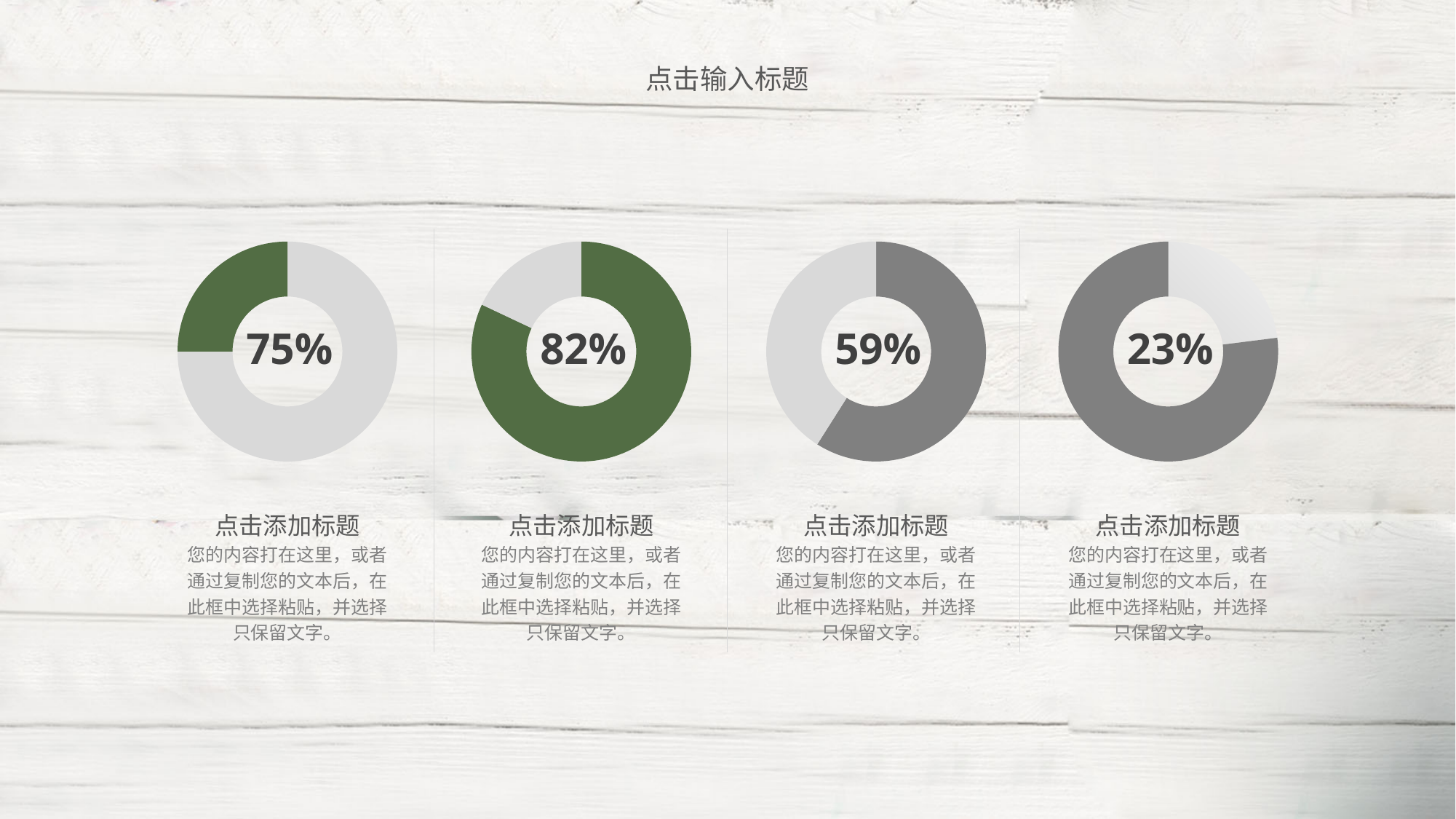
What is the difference between the percentage in the leftmost donut chart and the percentage in the third donut chart? 16% Which of the four donut charts shows the highest percentage? The second from the left (82%) Which shows a larger percentage, the leftmost donut chart or the third donut chart from the left? The leftmost (75%) What percentage is shown in the center of the third donut chart from the left? 59% What percentage is shown in the center of the second donut chart from the left? 82% How many donut charts are on the slide? 4 Which of the four donut charts shows the lowest percentage? The rightmost (23%) What percentage is shown in the center of the leftmost donut chart? 75% What percentage is shown in the center of the rightmost donut chart? 23% What is the difference between the percentage in the second donut chart and the percentage in the rightmost donut chart? 59% What colour is the filled segment in the two donut charts on the left side of the slide? Green What kind of chart is used to display the percentages on this slide? Donut chart